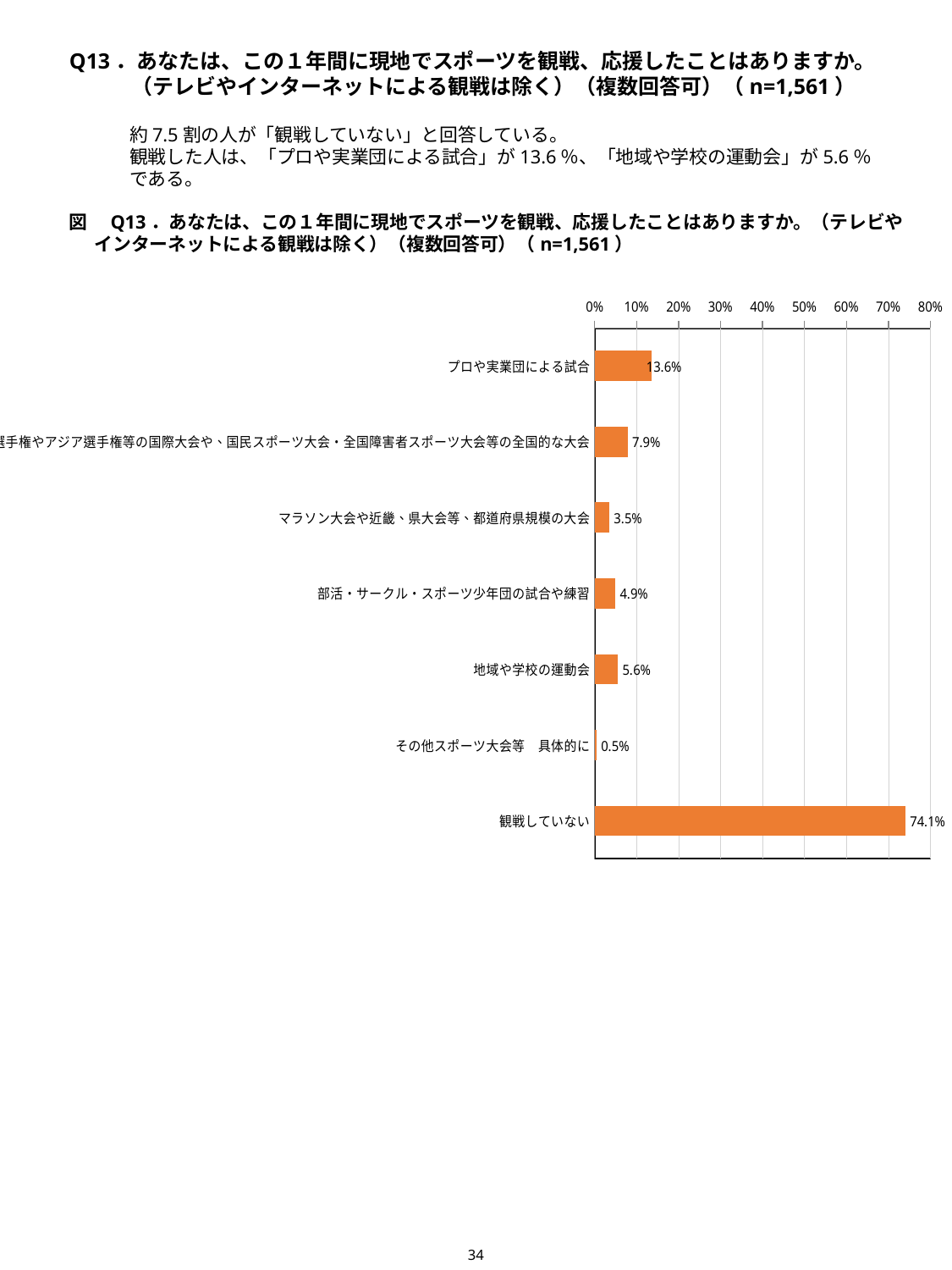
「地域や学校の運動会」の値は何%ですか。 5.6% 最も値が高い項目はどれですか。 観戦していない 最も値が低い項目はどれですか。 その他スポーツ大会等 具体的に 「プロや実業団による試合」の値は何%ですか。 13.6% 「部活・サークル・スポーツ少年団の試合や練習」と「マラソン大会や近畿、県大会等、都道府県規模の大会」では、どちらの値が大きいですか。 部活・サークル・スポーツ少年団の試合や練習 グラフの横軸の最大目盛りは何%ですか。 80% 「プロや実業団による試合」と「地域や学校の運動会」の値の差は何ポイントですか。 8.0ポイント 「観戦していない」の値は70%より大きいですか、小さいですか。 greater 「観戦していない」の値は何%ですか。 74.1% 「マラソン大会や近畿、県大会等、都道府県規模の大会」の値は何%ですか。 3.5% これはどの種類のグラフですか。 bar chart グラフには項目がいくつありますか。 7